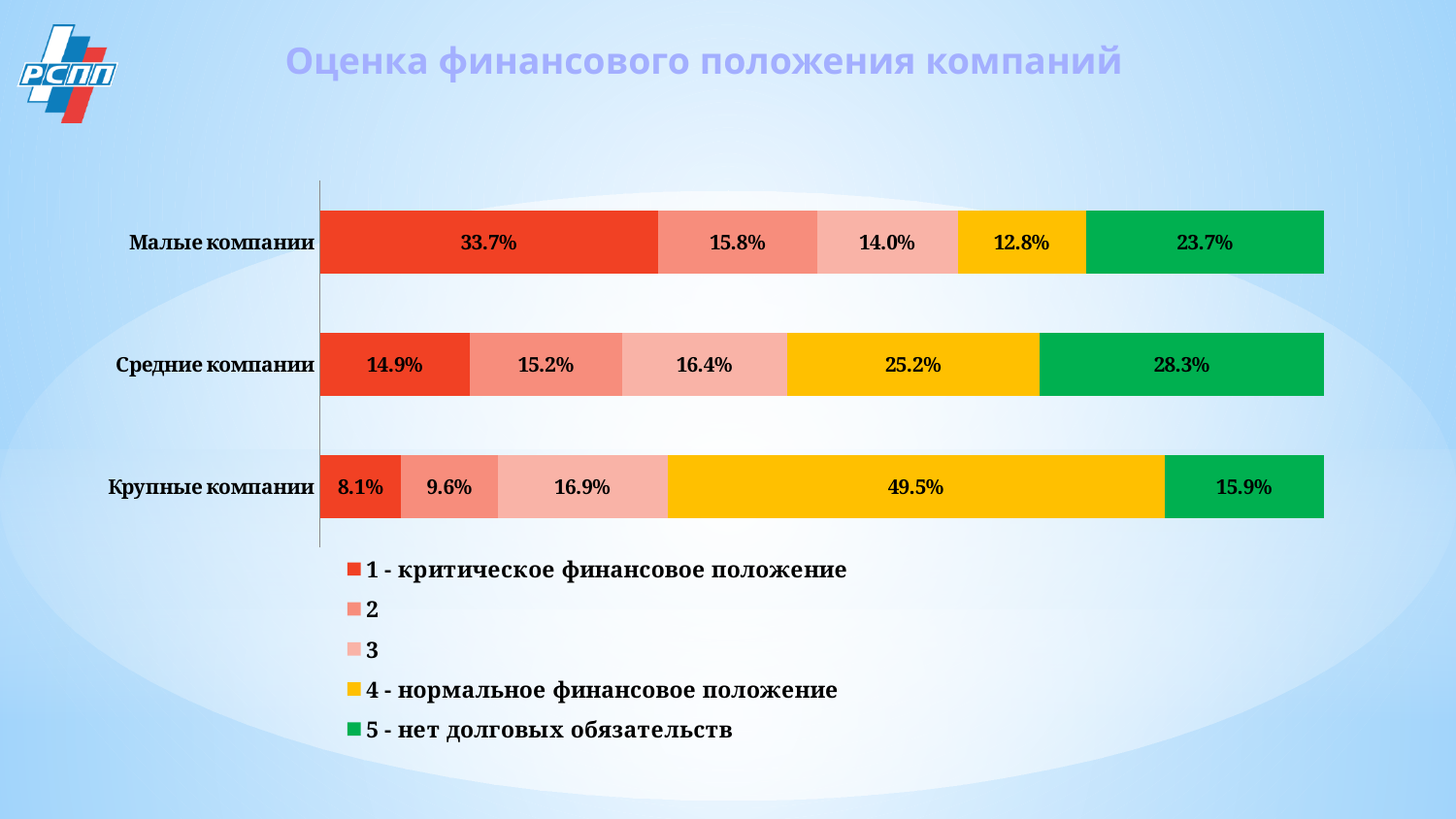
What is the title of the slide? Оценка финансового положения компаний How many series does the legend list? 5 What share of Малые компании falls in category "1 - критическое финансовое положение"? 33.7% What share of Крупные компании falls in category "4 - нормальное финансовое положение"? 49.5% What share of Средние компании falls in category "5 - нет долговых обязательств"? 28.3% Which company group has the lowest share in category "4 - нормальное финансовое положение"? Малые компании Which company group has the highest share in category "1 - критическое финансовое положение"? Малые компании How many company groups are shown in the chart? 3 What is the total of the stacked bar for Крупные компании? 100.0% Which is larger: the "5 - нет долговых обязательств" share for Малые компании or for Крупные компании? Малые компании What type of chart is shown on the slide? Stacked bar chart What is the difference between the "4 - нормальное финансовое положение" shares of Крупные компании and Средние компании? 24.3%